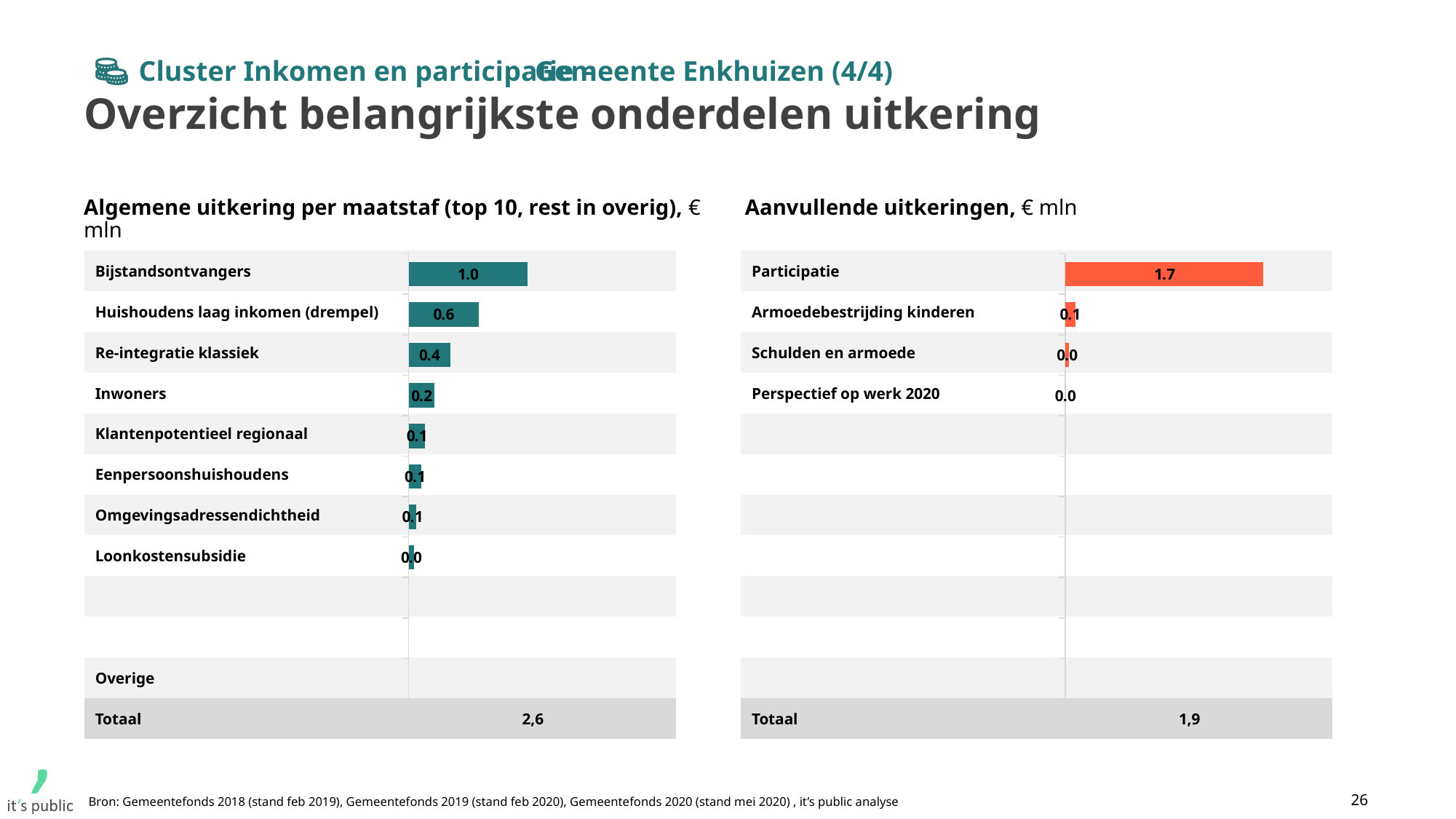
In the chart 'Aanvullende uitkeringen', what is the value for Participatie? 1.7 In the chart 'Aanvullende uitkeringen', how many categories are listed? 4 In the chart 'Aanvullende uitkeringen', what is the difference between Participatie and Armoedebestrijding kinderen? 1.6 In the chart 'Algemene uitkering per maatstaf', what is the value for Re-integratie klassiek? 0.4 In the chart 'Aanvullende uitkeringen', what is the value for Armoedebestrijding kinderen? 0.1 In the chart 'Algemene uitkering per maatstaf', what is the difference between Bijstandsontvangers and Huishoudens laag inkomen (drempel)? 0.4 In the chart 'Algemene uitkering per maatstaf', what is the value for Bijstandsontvangers? 1.0 What kind of chart is 'Aanvullende uitkeringen'? Bar chart In the chart 'Algemene uitkering per maatstaf', which category has the highest value? Bijstandsontvangers What total (Totaal) is shown below the chart 'Algemene uitkering per maatstaf'? 2,6 In the chart 'Aanvullende uitkeringen', which category has the highest value? Participatie In the chart 'Algemene uitkering per maatstaf', which is larger: Huishoudens laag inkomen (drempel) or Inwoners? Huishoudens laag inkomen (drempel)